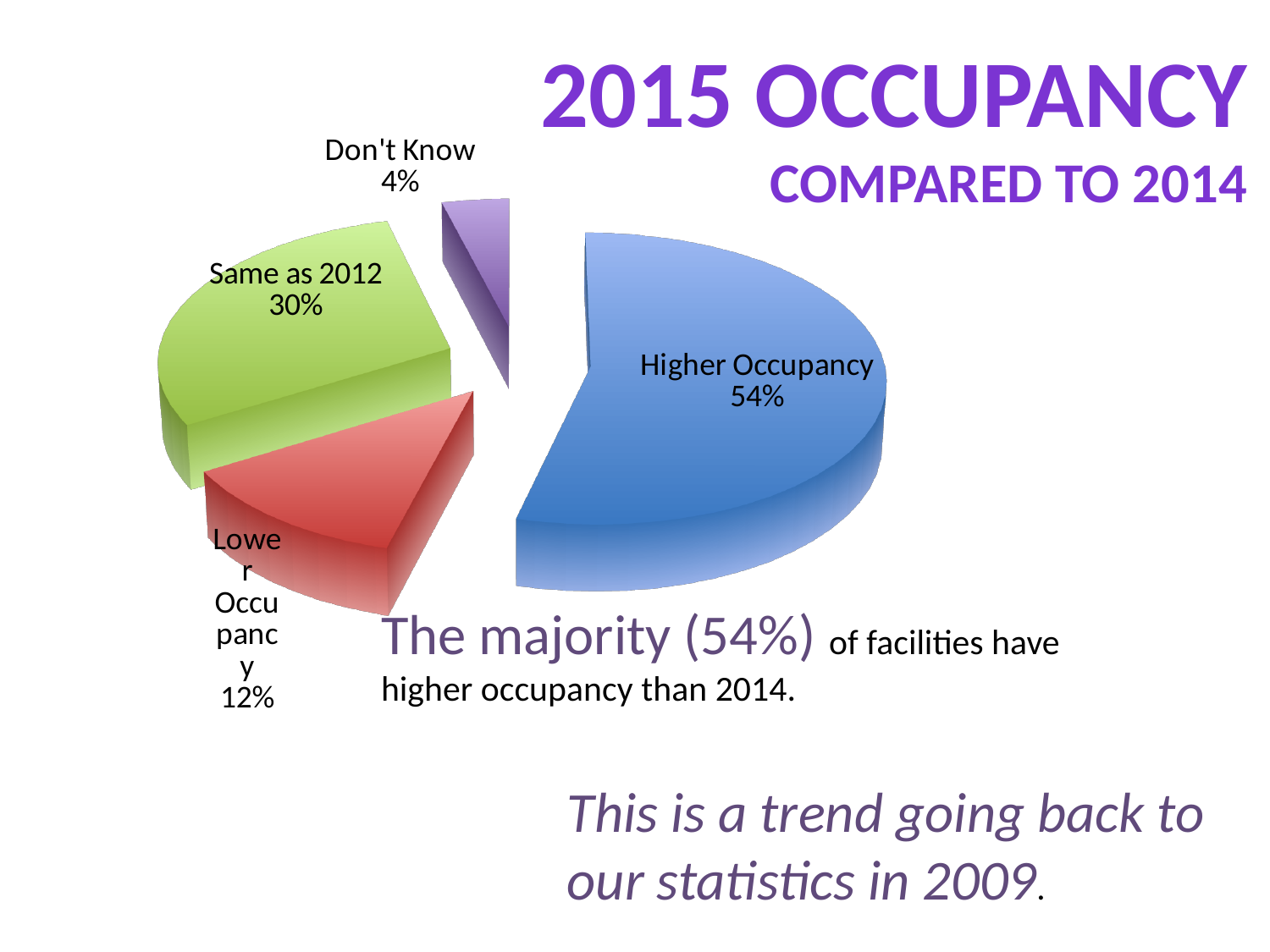
Which slice of the pie is the smallest? Don't Know What is the difference in percentage points between the Lower Occupancy slice and the Don't Know slice? 8 What share of the pie is labelled Lower Occupancy? 12% How many slices does the pie chart have? 4 What kind of chart is shown on the slide? Pie chart What colour is the Higher Occupancy slice? Blue What share of the pie is labelled Higher Occupancy? 54% What share of the pie is labelled Same as 2012? 30% Which slice of the pie is the largest? Higher Occupancy Which is larger, the Same as 2012 slice or the Lower Occupancy slice? Same as 2012 What is the difference in percentage points between the Higher Occupancy slice and the Same as 2012 slice? 24